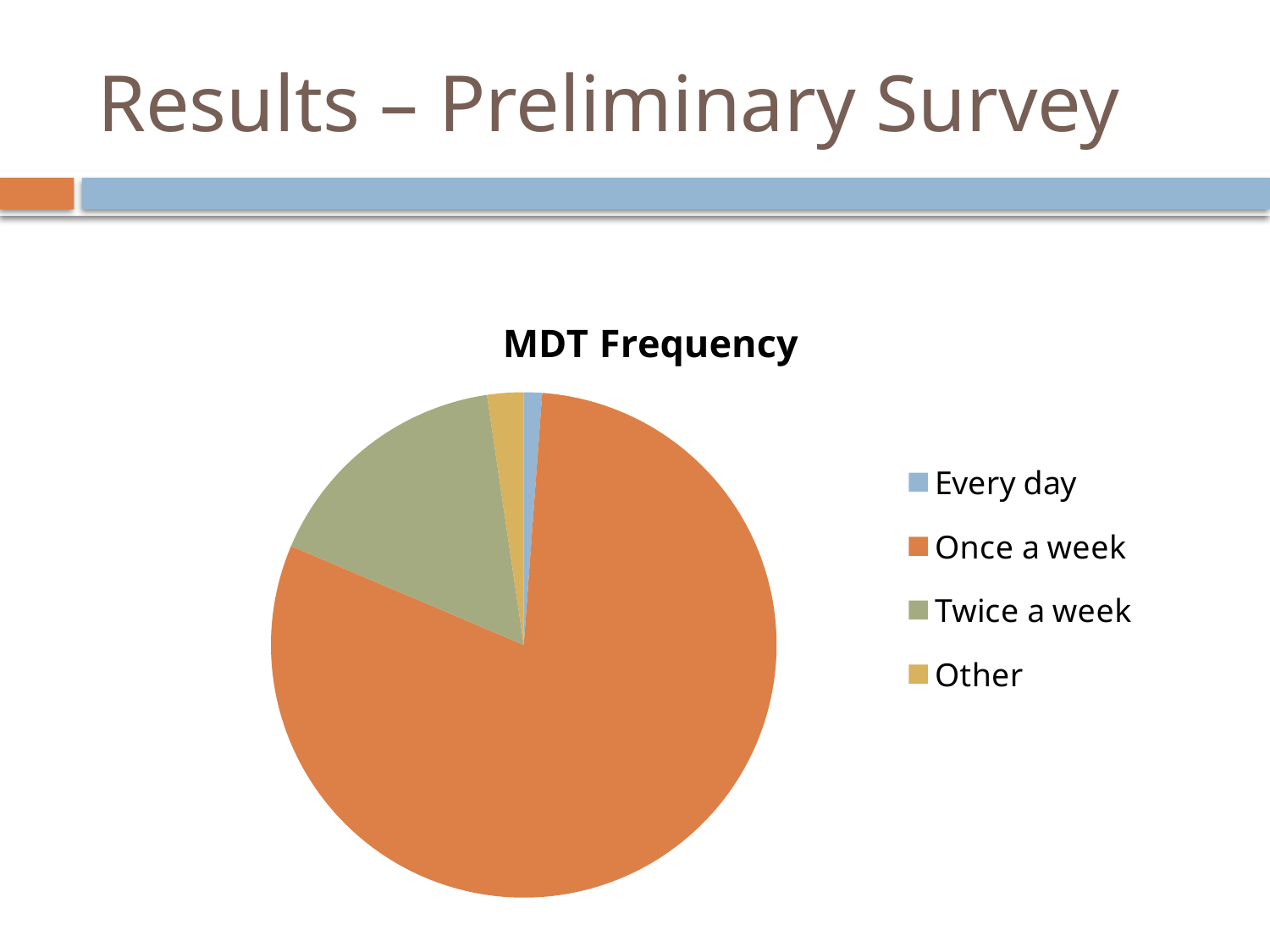
Which slice is larger, Twice a week or Other? Twice a week How many categories does the MDT Frequency pie chart have? 4 Which slice is larger, Once a week or Twice a week? Once a week What is the title of the pie chart? MDT Frequency What kind of chart is shown on the slide? pie chart Which category has the largest slice in the MDT Frequency pie chart? Once a week Does the Once a week slice take up more or less than half of the pie? more What colour is the Once a week slice in the pie chart? orange